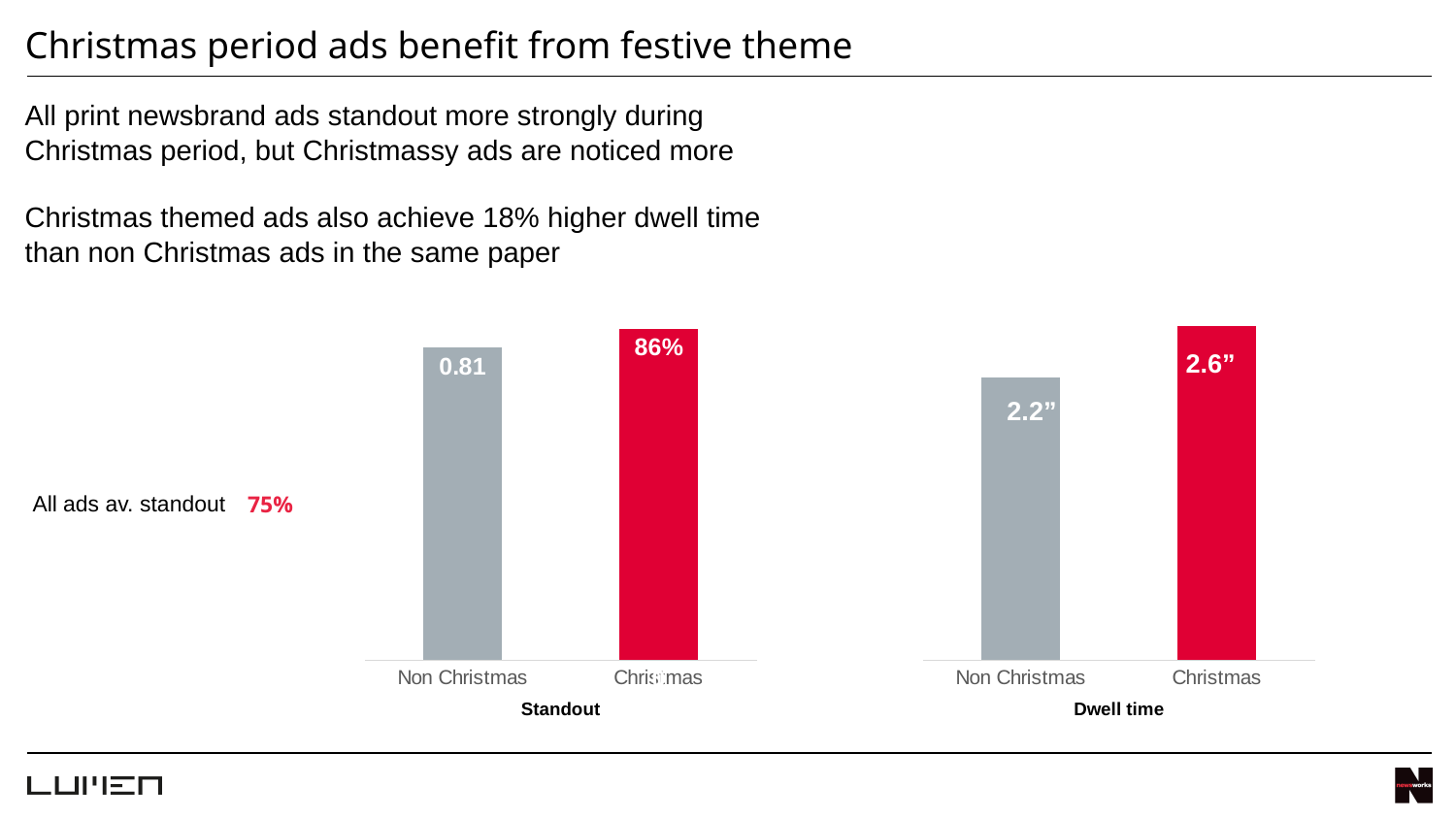
What is the title of the chart on the right of the slide? Dwell time In the Dwell time chart, what is the value for Christmas? 2.6" In the Standout chart, which category has the lowest value? Non Christmas In the Dwell time chart, what is the value for Non Christmas? 2.2" How many categories are shown in the Dwell time chart? 2 In the Dwell time chart, what colour is the Christmas bar? Red In the Standout chart, what is the value for Christmas? 86% In the Standout chart, which is larger, the Christmas bar or the Non Christmas bar? Christmas In the Dwell time chart, what is the difference between the Christmas and Non Christmas values? 0.4" In the Dwell time chart, which category has the highest value? Christmas In the Standout chart, what is the value for Non Christmas? 0.81 What type of chart is the Standout chart? Bar chart